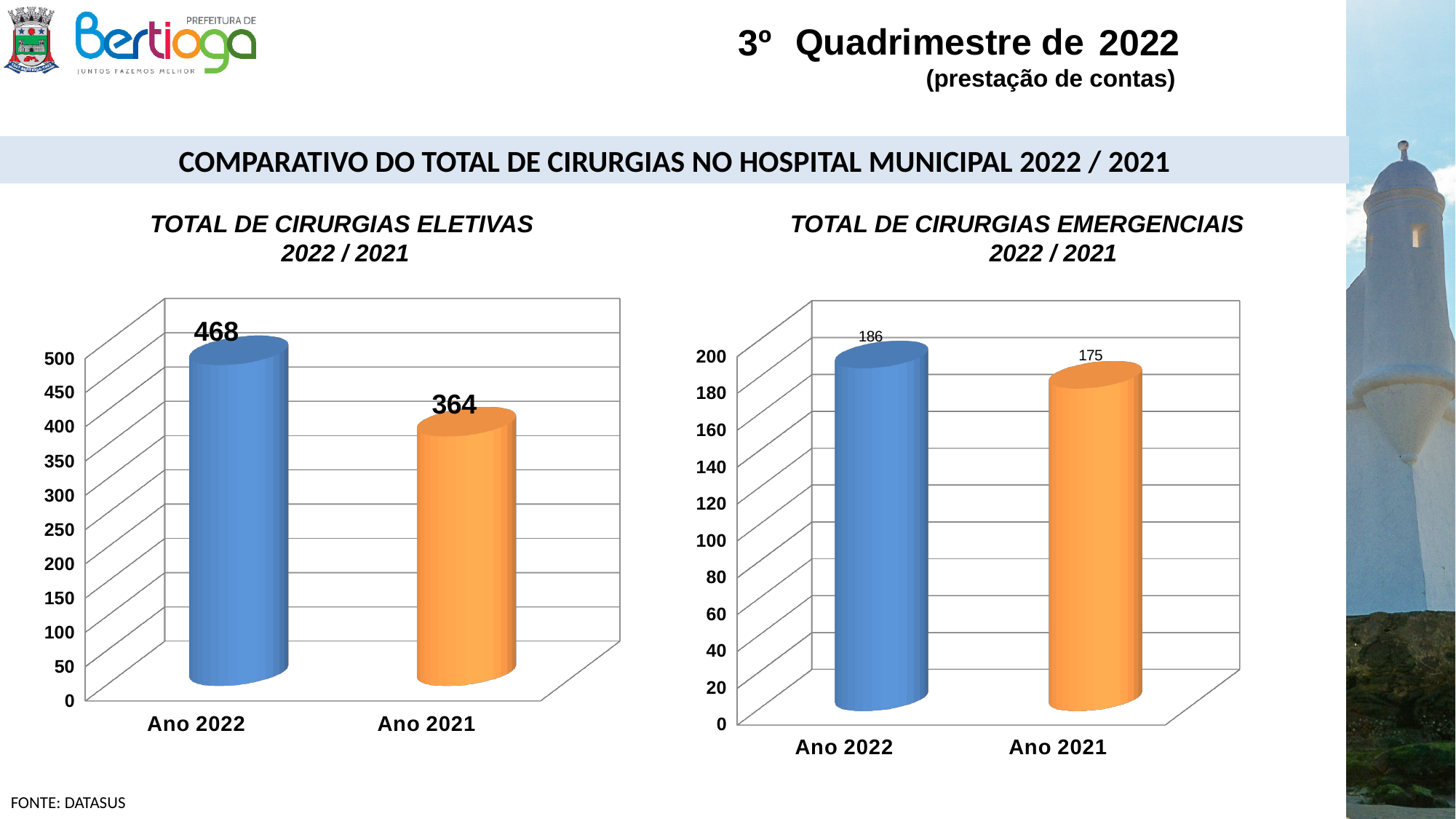
In the 'TOTAL DE CIRURGIAS EMERGENCIAIS 2022 / 2021' chart, what is the value for Ano 2021? 175 In the 'TOTAL DE CIRURGIAS EMERGENCIAIS 2022 / 2021' chart, what is the value for Ano 2022? 186 In the 'TOTAL DE CIRURGIAS ELETIVAS 2022 / 2021' chart, what is the value for Ano 2022? 468 In the 'TOTAL DE CIRURGIAS EMERGENCIAIS 2022 / 2021' chart, what is the difference between the values for Ano 2022 and Ano 2021? 11 In the 'TOTAL DE CIRURGIAS EMERGENCIAIS 2022 / 2021' chart, which is larger, the value for Ano 2022 or Ano 2021? Ano 2022 In the 'TOTAL DE CIRURGIAS EMERGENCIAIS 2022 / 2021' chart, which year has the lowest value? Ano 2021 In the 'TOTAL DE CIRURGIAS ELETIVAS 2022 / 2021' chart, which year has the highest value? Ano 2022 In the 'TOTAL DE CIRURGIAS ELETIVAS 2022 / 2021' chart, is the value for Ano 2021 greater or less than 400? less How many categories are shown in the 'TOTAL DE CIRURGIAS ELETIVAS 2022 / 2021' chart? 2 In the 'TOTAL DE CIRURGIAS ELETIVAS 2022 / 2021' chart, what is the value for Ano 2021? 364 In the 'TOTAL DE CIRURGIAS ELETIVAS 2022 / 2021' chart, what is the difference between the values for Ano 2022 and Ano 2021? 104 What kind of chart is the 'TOTAL DE CIRURGIAS EMERGENCIAIS 2022 / 2021' chart? bar chart